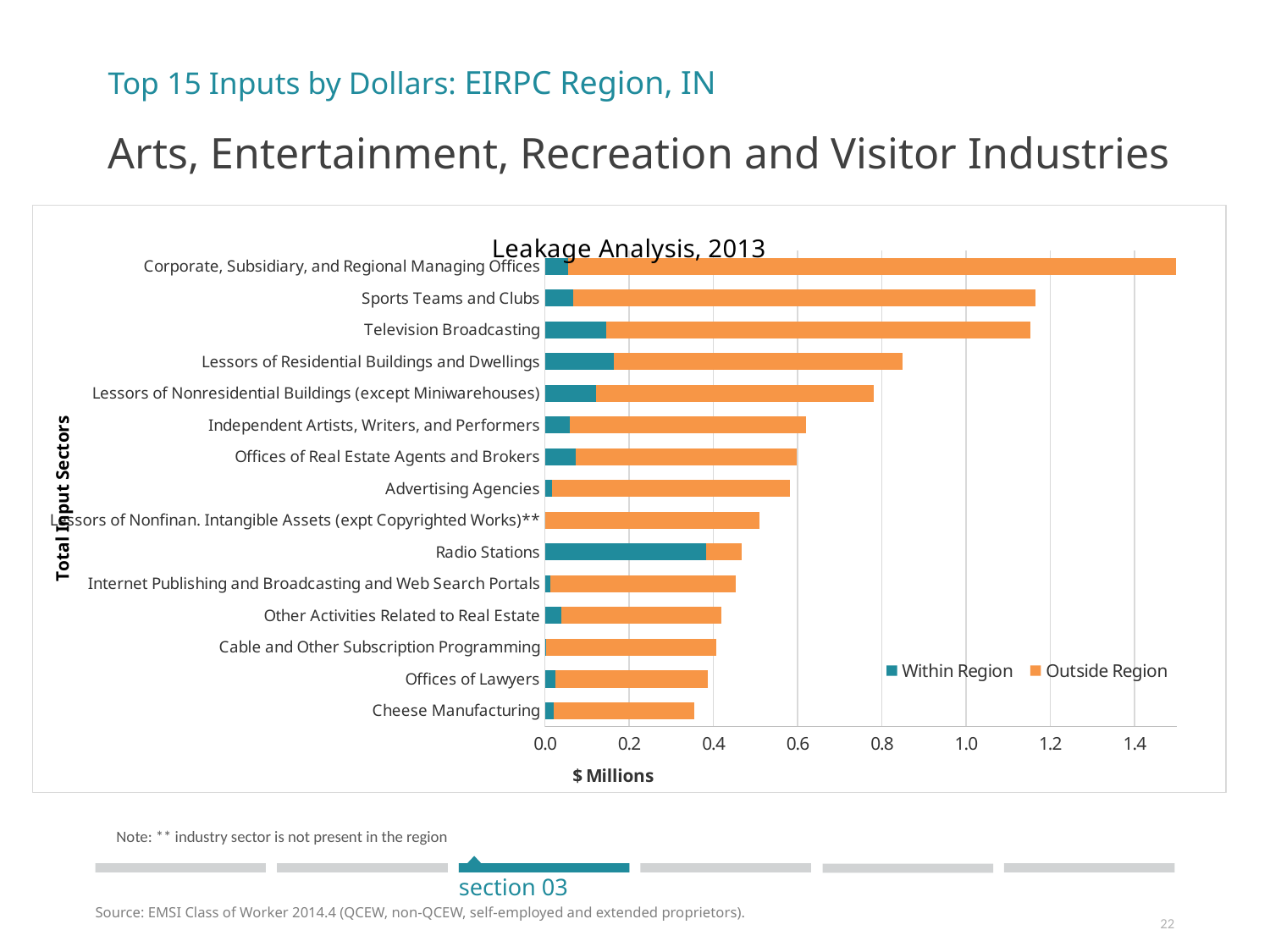
Is the Within Region value for Radio Stations greater or less than 0.2? greater Which input sector has the longest total bar? Corporate, Subsidiary, and Regional Managing Offices Which input sector has the largest Within Region segment? Radio Stations What is the label on the horizontal axis of the chart? $ Millions How many input sectors are listed on the chart? 15 How many series does the legend list? 2 Is the total value for Corporate, Subsidiary, and Regional Managing Offices greater or less than 1.4? greater Which has a larger Within Region value, Radio Stations or Television Broadcasting? Radio Stations Which input sector has the shortest total bar? Cheese Manufacturing What type of chart is shown on the slide? Stacked bar chart Is the total value for Television Broadcasting greater or less than 1.0? greater